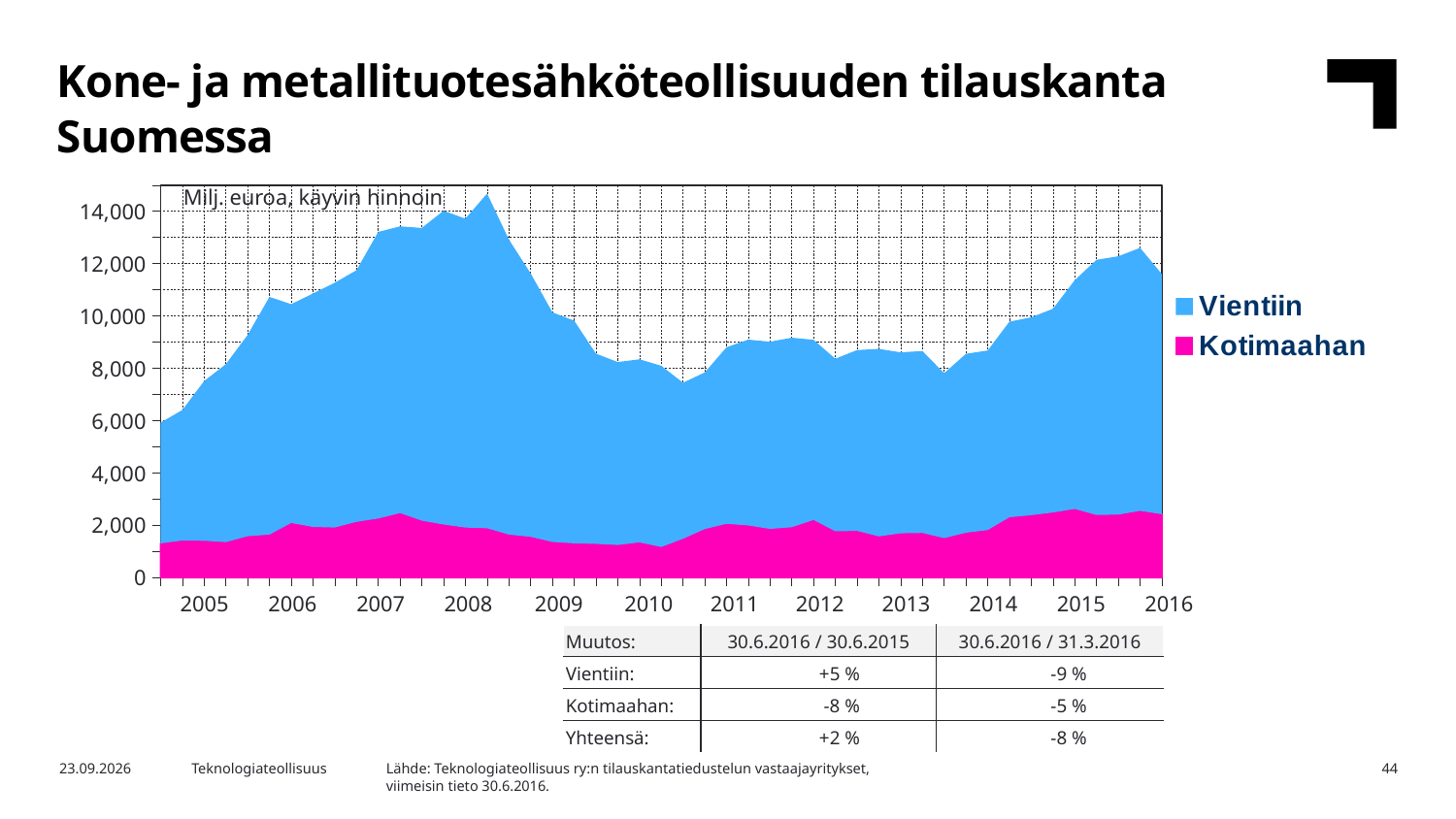
Does the total order stock rise or fall between its 2008 peak and 2009? fall Is the total order stock at the end of the chart in 2016 greater or less than 10,000? greater Does the total order stock rise or fall between 2013 and 2015? rise Which two series are listed in the chart legend? Vientiin and Kotimaahan Which series is larger throughout the chart, Vientiin or Kotimaahan? Vientiin Is the Kotimaahan value in 2010 greater or less than 2,000? less What kind of chart is shown on the slide? Area chart What unit label is shown at the top of the chart's plot area? Milj. euroa, käyvin hinnoin Is the total order stock at the start of 2005 greater or less than 8,000? less How many year labels are shown on the x axis? 12 How many series does the chart legend list? 2